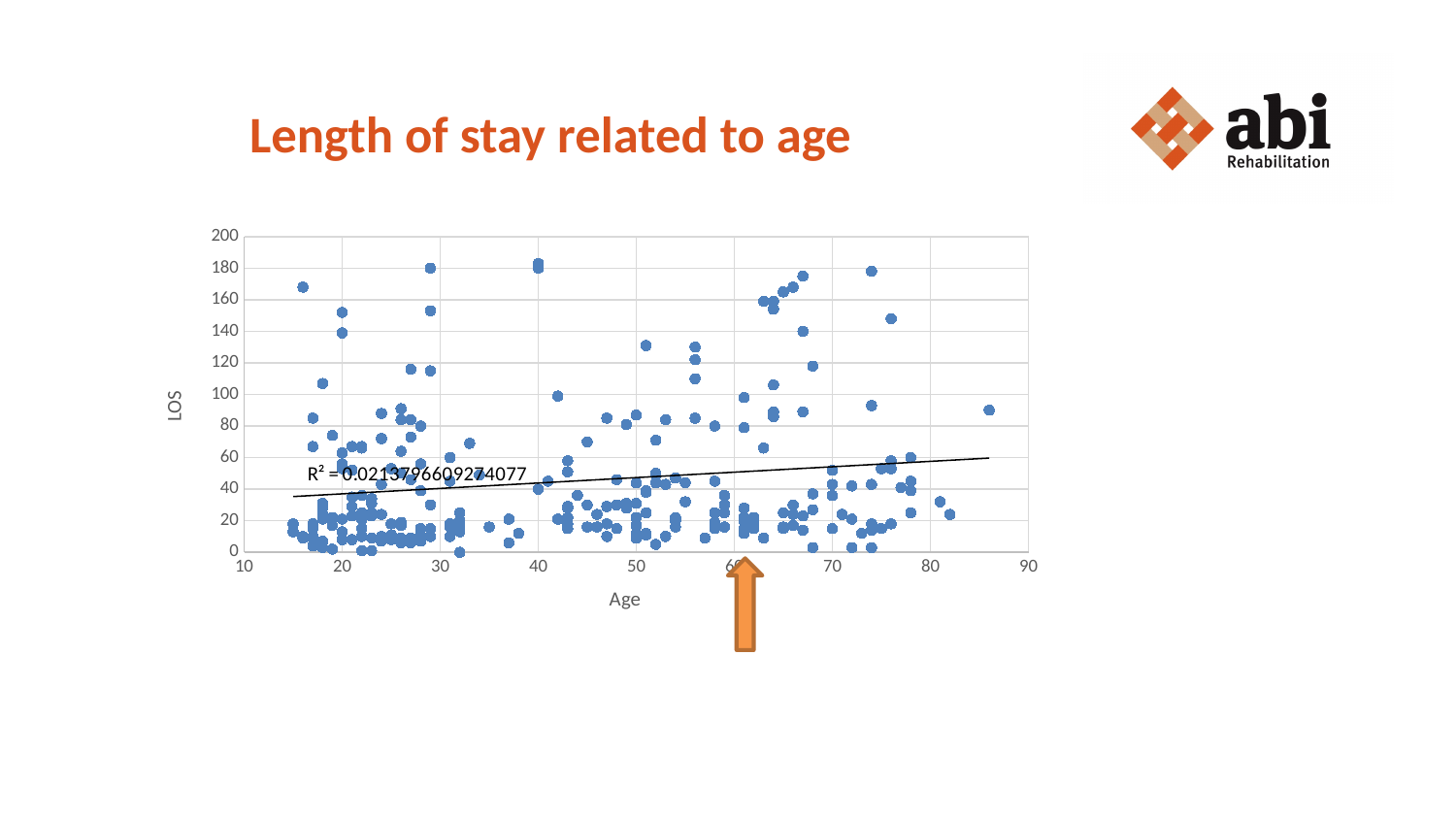
What label is shown on the horizontal axis of the chart? Age What is the title of the chart? Length of stay related to age What kind of chart is shown on the slide? Scatter chart Does the trendline rise or fall as age increases? Rises Is the R² value of the trendline greater or less than 0.1? less Is the LOS value of the trendline at age 80 greater or less than 40? greater Is the LOS value of the trendline at age 20 greater or less than 60? less What is the R² value printed on the chart? R² = 0.0213796609274077 What is the lowest value shown on the horizontal (Age) axis? 10 What is the maximum value shown on the vertical (LOS) axis? 200